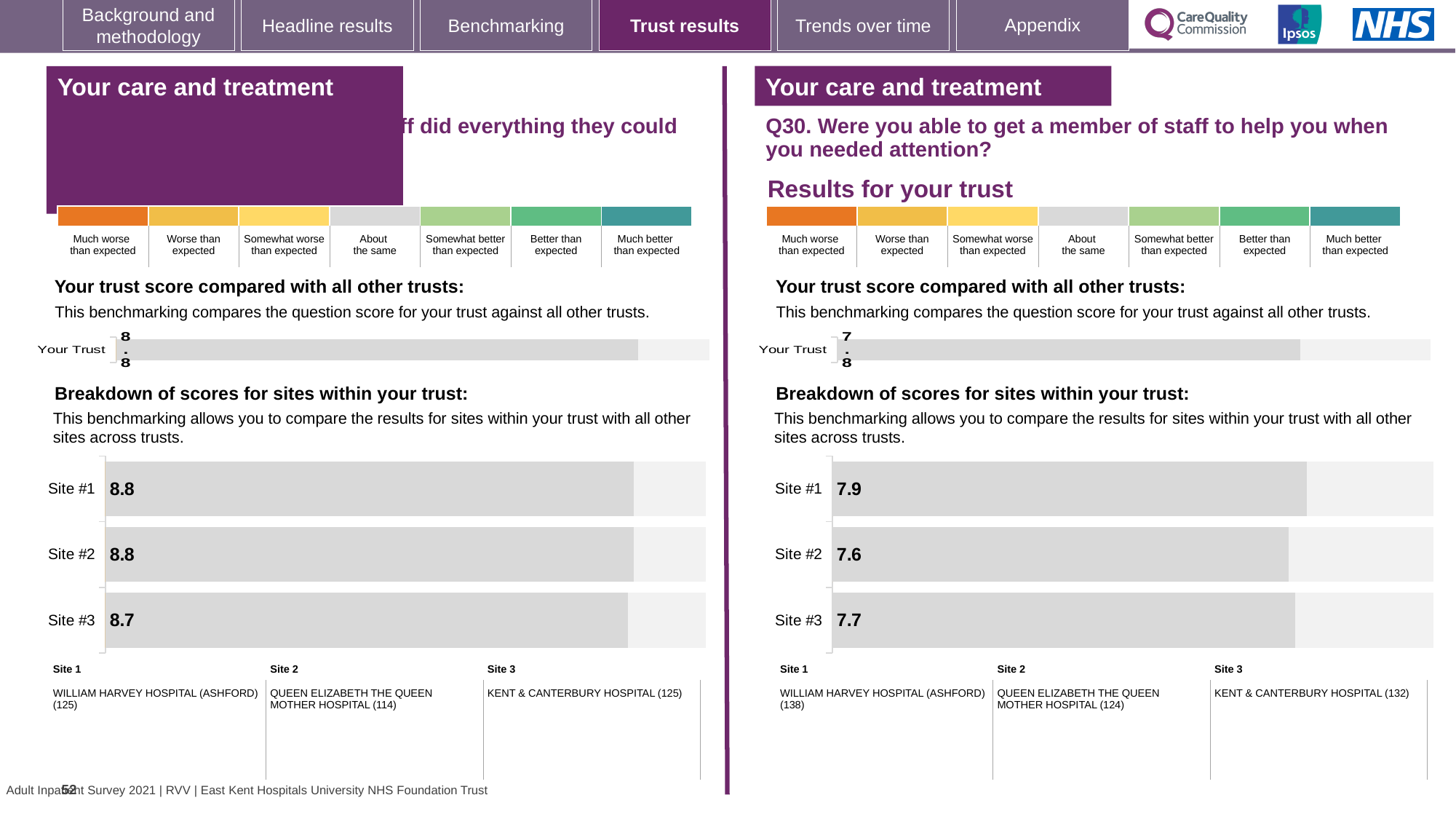
On the right-hand (Q30) site breakdown chart, which site has the lowest score? Site #2 On the right-hand (Q30) 'Breakdown of scores for sites within your trust' chart, what is the score for Site #2? 7.6 On the left-hand 'Breakdown of scores for sites within your trust' chart, what is the score for Site #3? 8.7 On the left-hand site breakdown chart, how many sites are shown? 3 On the left-hand site breakdown chart, which site has the lowest score? Site #3 On the right-hand (Q30) 'Breakdown of scores for sites within your trust' chart, what is the score for Site #1? 7.9 On the right-hand (Q30) site breakdown chart, which site has the highest score? Site #1 On the right-hand (Q30) site breakdown chart, what is the difference between the scores for Site #1 and Site #2? 0.3 On the right-hand (Q30) 'Your trust score compared with all other trusts' chart, what is the score for Your Trust? 7.8 On the left-hand 'Your trust score compared with all other trusts' chart, what is the score for Your Trust? 8.8 Which is larger: the Your Trust score on the left-hand chart or the Your Trust score on the right-hand (Q30) chart? The left-hand chart (8.8) What type of chart is used for the site breakdown on the right-hand (Q30) side of the slide? Bar chart